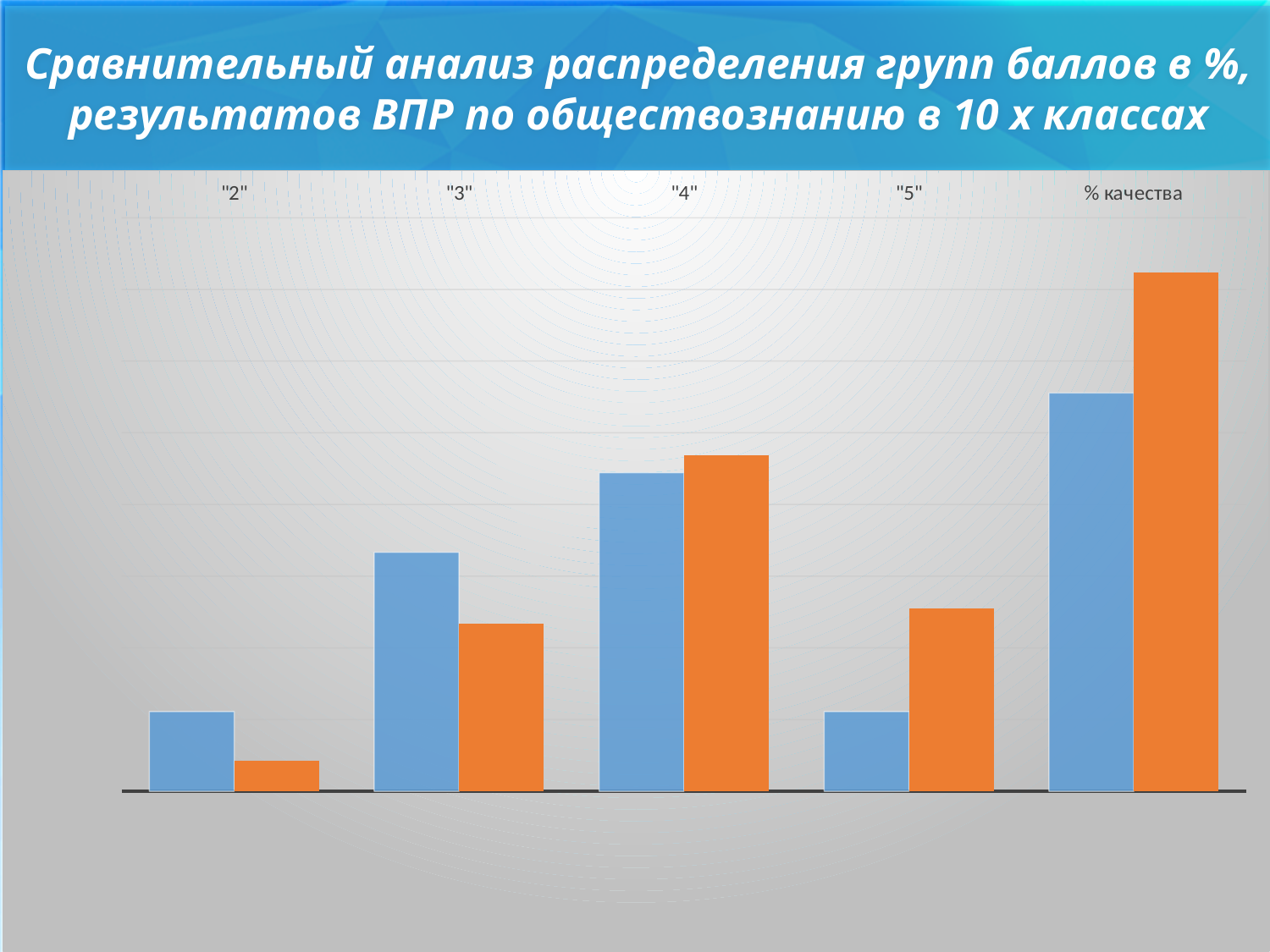
In the "% качества" category, which bar is taller, the blue one or the orange one? orange For which category is the blue bar the tallest? % качества In the "2" category, which bar is taller, the blue one or the orange one? blue What is the label of the last category on the x axis of the chart? % качества How many bars are plotted for each category in the chart? 2 For which category is the orange bar the shortest? "2" What two colours are used for the bars in the chart? blue and orange How many categories are shown along the x axis of the chart? 5 In the "3" category, which bar is taller, the blue one or the orange one? blue For which category is the orange bar the tallest? % качества What kind of chart is shown on the slide? bar chart